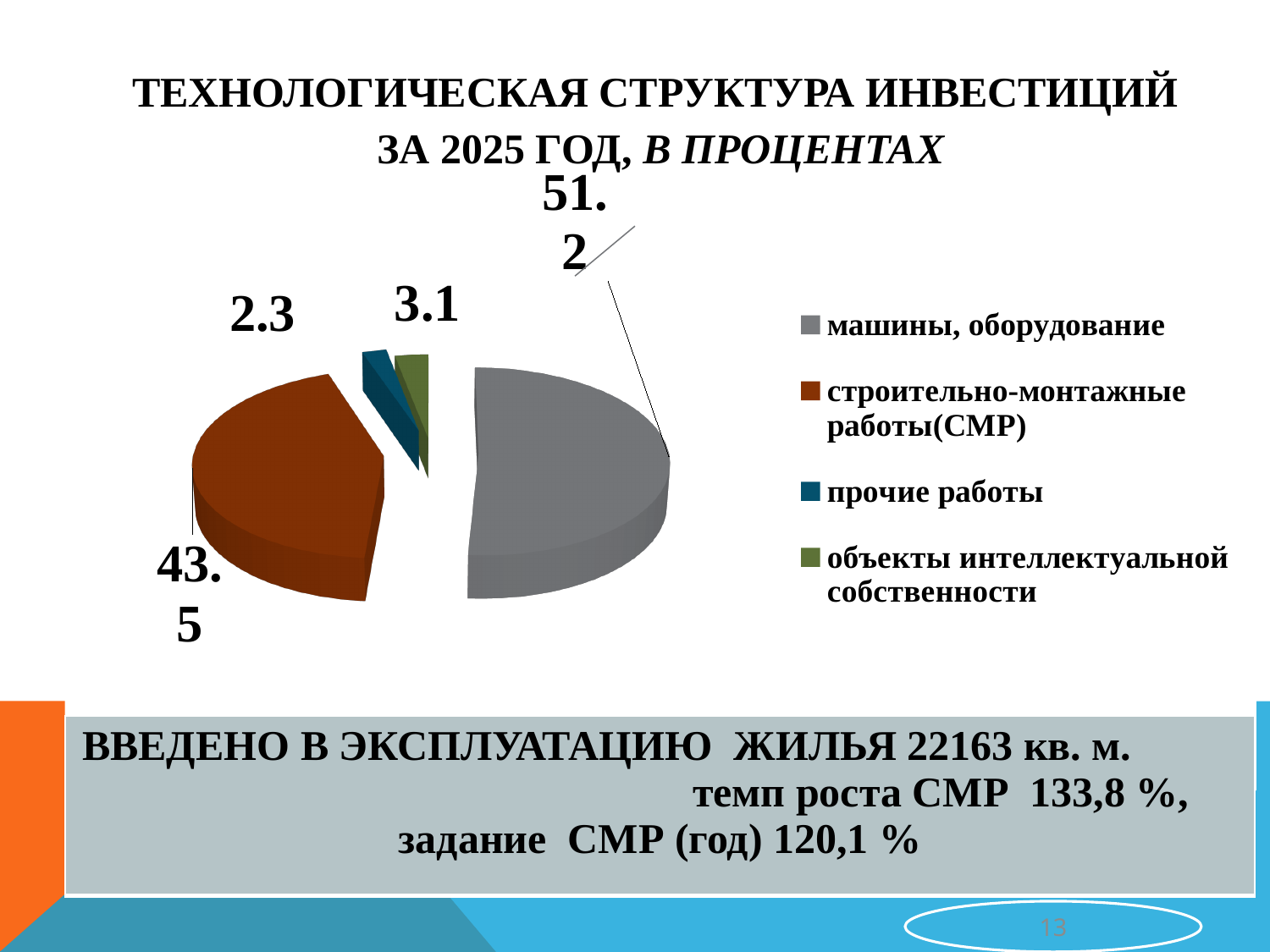
What share of the pie, in percent, does машины, оборудование account for? 51.2 What kind of chart is shown on the slide? pie chart How many entries does the legend of the pie chart list? 4 What is the title of the chart on the slide? ТЕХНОЛОГИЧЕСКАЯ СТРУКТУРА ИНВЕСТИЦИЙ ЗА 2025 ГОД, В ПРОЦЕНТАХ How many slices does the pie chart have? 4 What is the difference between the values for машины, оборудование and строительно-монтажные работы (СМР)? 7.7 What is the value shown for строительно-монтажные работы (СМР)? 43.5 Which is larger: the value for машины, оборудование or the value for строительно-монтажные работы (СМР)? машины, оборудование What is the value shown for машины, оборудование? 51.2 Which category has the largest slice of the pie? машины, оборудование Which category has the smallest slice of the pie? прочие работы What is the value shown for объекты интеллектуальной собственности? 3.1